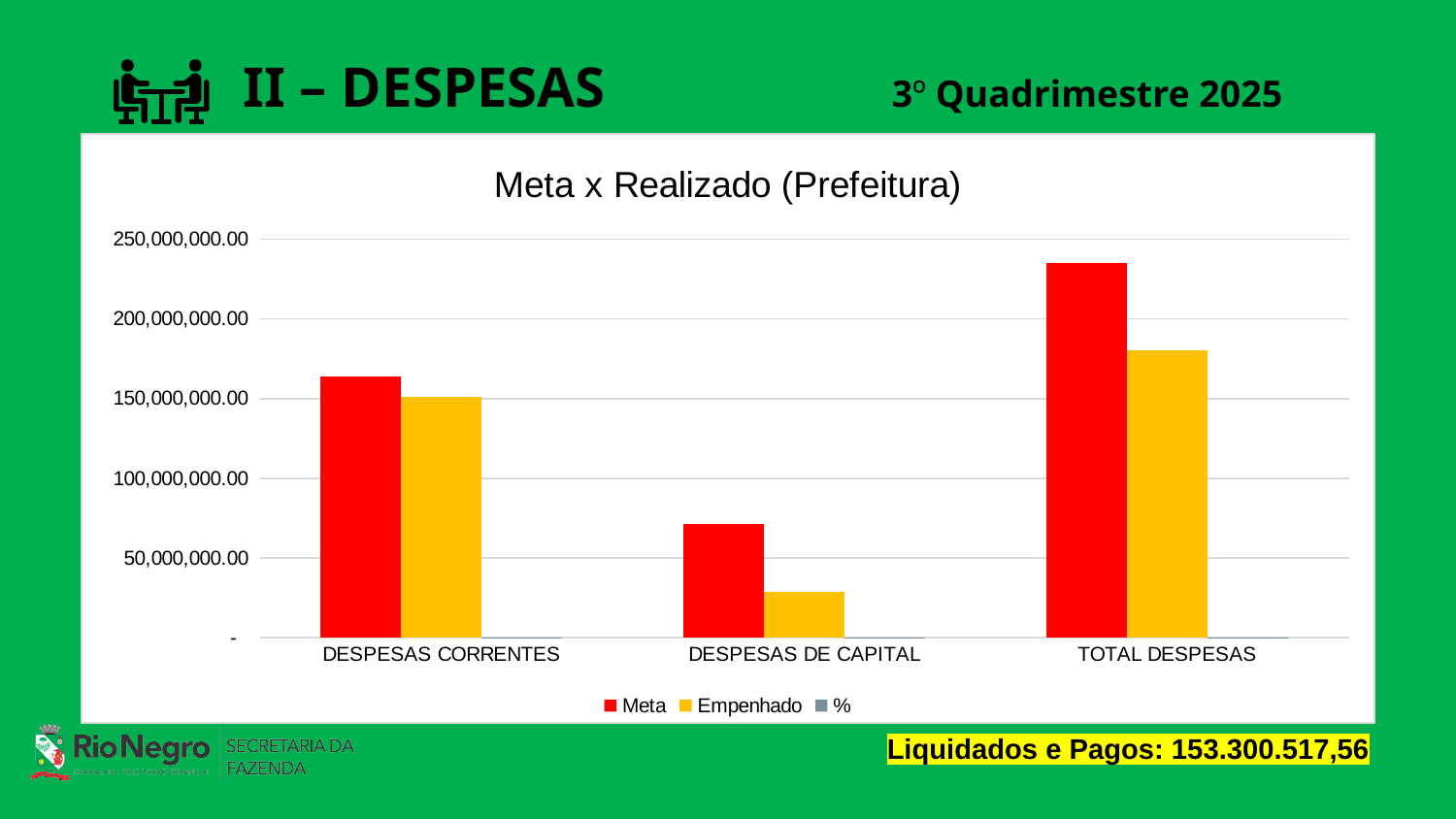
What kind of chart is shown on the slide? bar chart Is the Meta value for DESPESAS CORRENTES greater or less than 150,000,000.00? greater Which category has the highest Meta value? TOTAL DESPESAS What is the title of the chart? Meta x Realizado (Prefeitura) For DESPESAS DE CAPITAL, which is larger: Meta or Empenhado? Meta Is the Meta value for DESPESAS DE CAPITAL greater or less than 100,000,000.00? less Which colour represents the Meta series in the chart legend? red How many series does the chart legend list? 3 How many categories are shown on the x axis of the chart? 3 Which category has the lowest Empenhado value? DESPESAS DE CAPITAL Is the Empenhado value for DESPESAS DE CAPITAL greater or less than 50,000,000.00? less